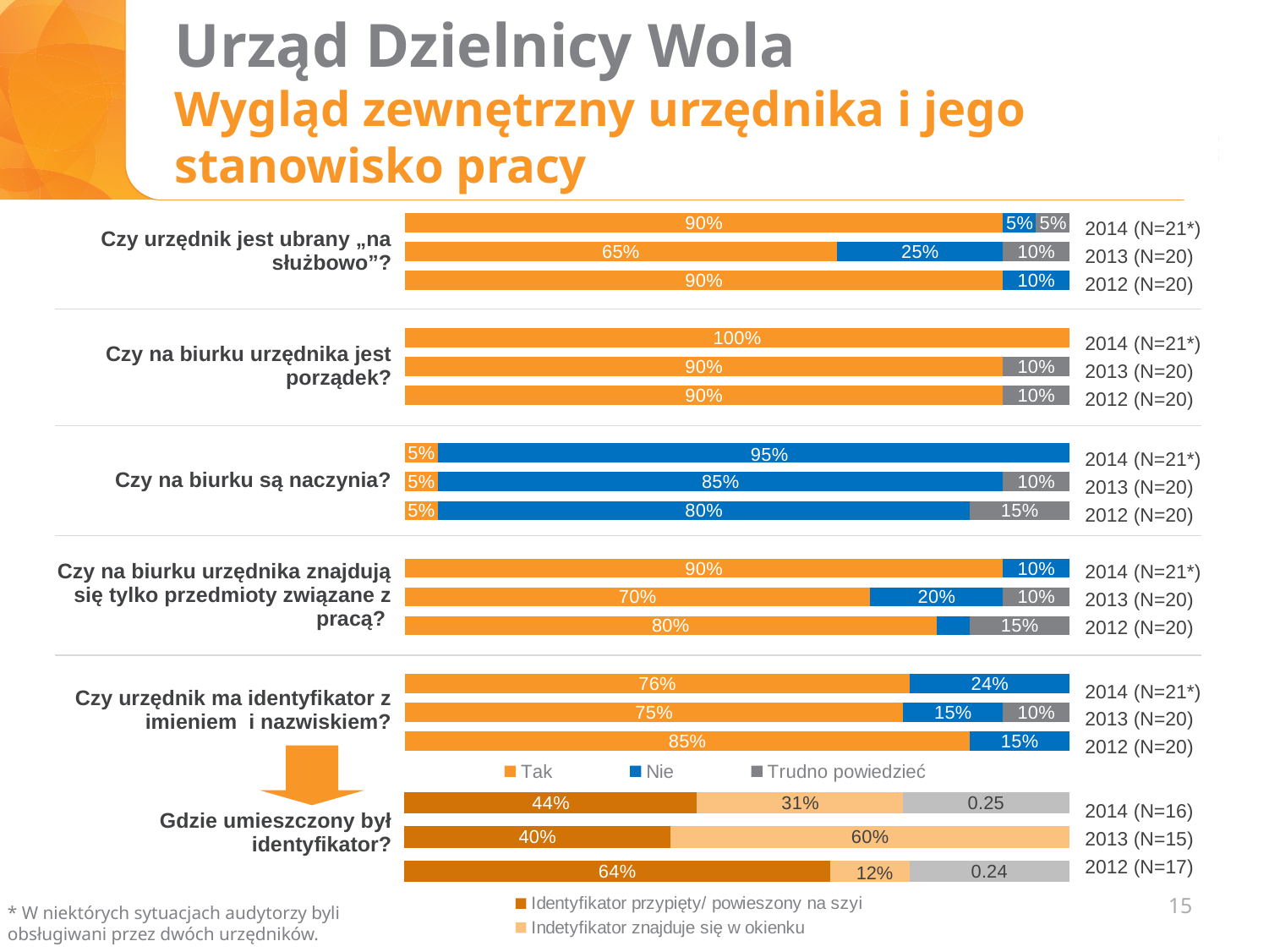
In the upper chart, for "Czy na biurku są naczynia?", which year has the larger "Nie" share: 2014 or 2012? 2014 What kind of chart is used on this slide? Stacked bar chart In the lower chart "Gdzie umieszczony był identyfikator?", what is the value for "Indetyfikator znajduje się w okienku" in 2013 (N=15)? 60% In the upper chart, what percentage answered "Nie" to "Czy urzędnik ma identyfikator z imieniem i nazwiskiem?" in 2014 (N=21*)? 24% In the upper chart, what is the difference between the "Tak" share for "Czy urzędnik jest ubrany „na służbowo”?" in 2014 and in 2013? 25 percentage points How many series does the legend of the upper chart list? 3 In the upper chart, for "Czy na biurku urzędnika znajdują się tylko przedmioty związane z pracą?", which year has the lowest "Tak" share? 2013 (N=20) In the upper chart, what percentage answered "Tak" to "Czy na biurku urzędnika jest porządek?" in 2014 (N=21*)? 100% In the upper chart, what percentage answered "Nie" to "Czy na biurku są naczynia?" in 2014 (N=21*)? 95% In the lower chart "Gdzie umieszczony był identyfikator?", what is the value for "Identyfikator przypięty/ powieszony na szyi" in 2012 (N=17)? 64% How many questions (categories) are shown in the upper chart? 5 In the upper chart, what percentage answered "Tak" to "Czy urzędnik jest ubrany „na służbowo”?" in 2013 (N=20)? 65%